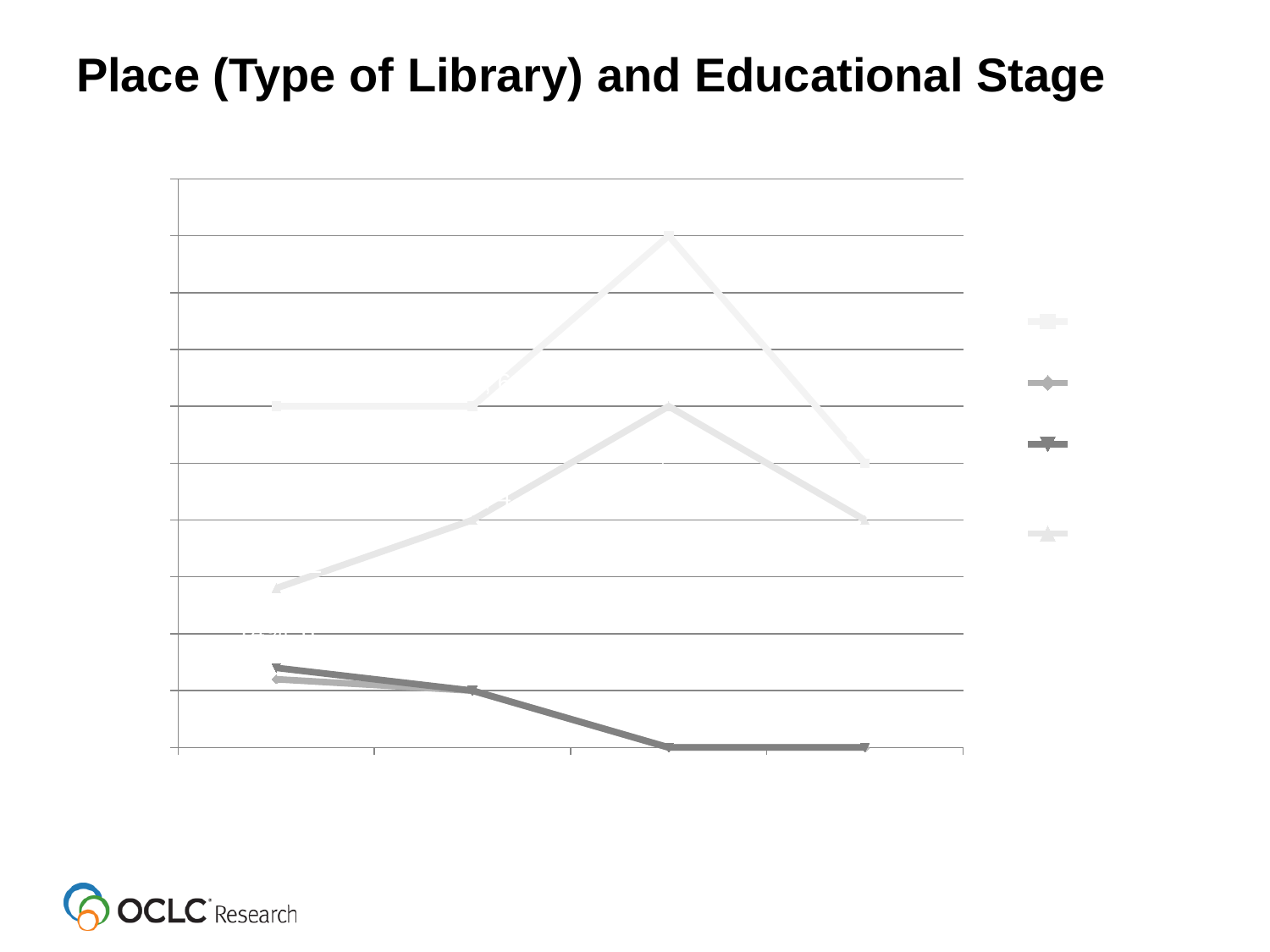
How many points are plotted along the x axis for each line? 4 What kind of chart is shown on the slide? line chart How many series does the legend list? 4 Does the darkest (dark grey) line rise or fall from left to right along the x axis? fall What is the title of the slide containing the chart? Place (Type of Library) and Educational Stage